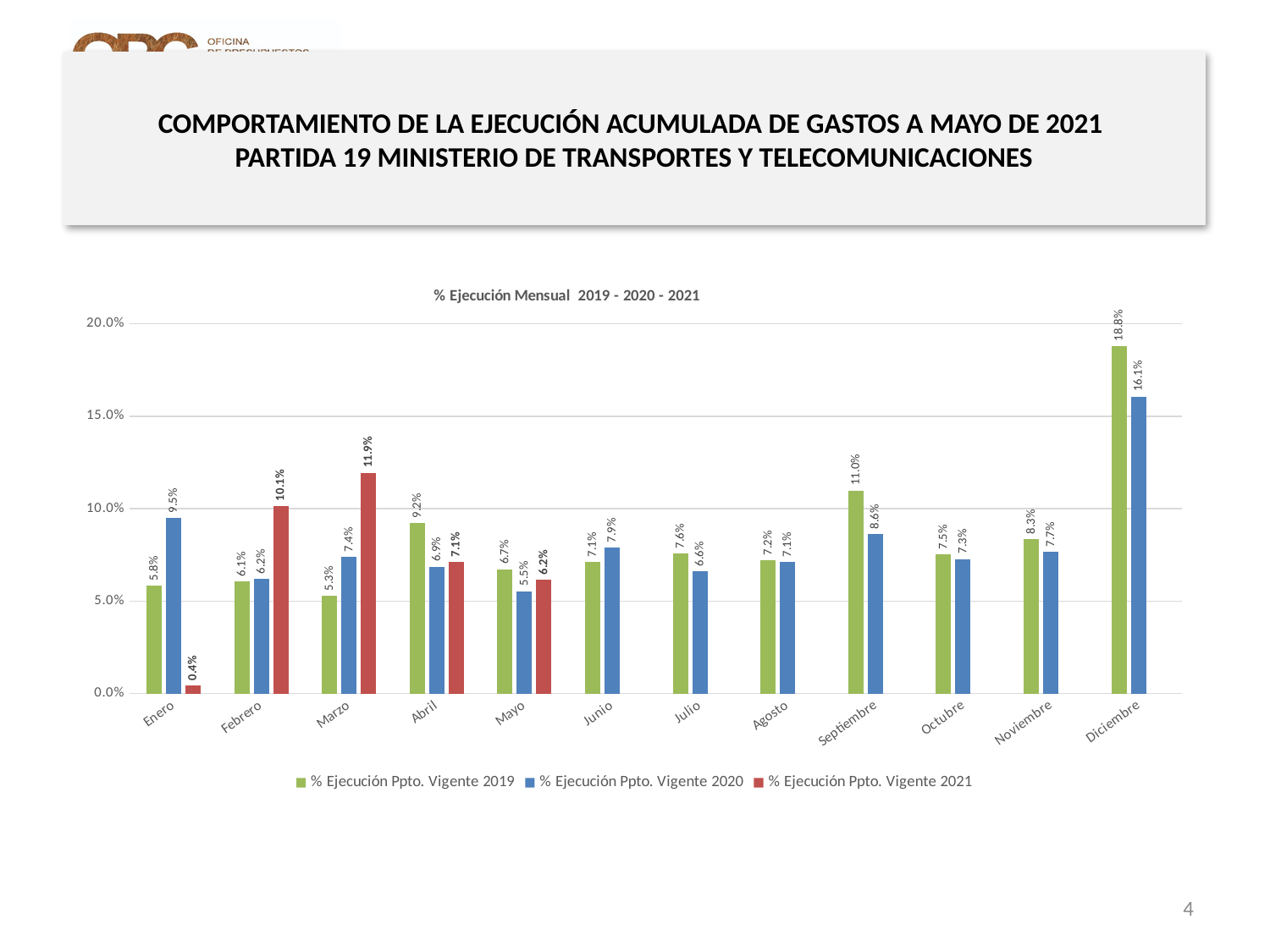
What is the value for % Ejecución Ppto. Vigente 2021 in Marzo? 11.9% Which month has the highest value for % Ejecución Ppto. Vigente 2019? Diciembre Which month has the lowest value for % Ejecución Ppto. Vigente 2021? Enero Is the value for % Ejecución Ppto. Vigente 2020 in Diciembre greater or less than 15.0%? greater What is the value for % Ejecución Ppto. Vigente 2019 in Septiembre? 11.0% In Abril, which series has the larger value: % Ejecución Ppto. Vigente 2019 or % Ejecución Ppto. Vigente 2020? % Ejecución Ppto. Vigente 2019 What is the difference between the 2019 and 2020 values in Diciembre? 2.7% How many series does the legend list? 3 How many months are shown on the x axis? 12 What is the title of the chart? % Ejecución Mensual 2019 - 2020 - 2021 What kind of chart is shown on the slide? Bar chart What is the value for % Ejecución Ppto. Vigente 2020 in Enero? 9.5%